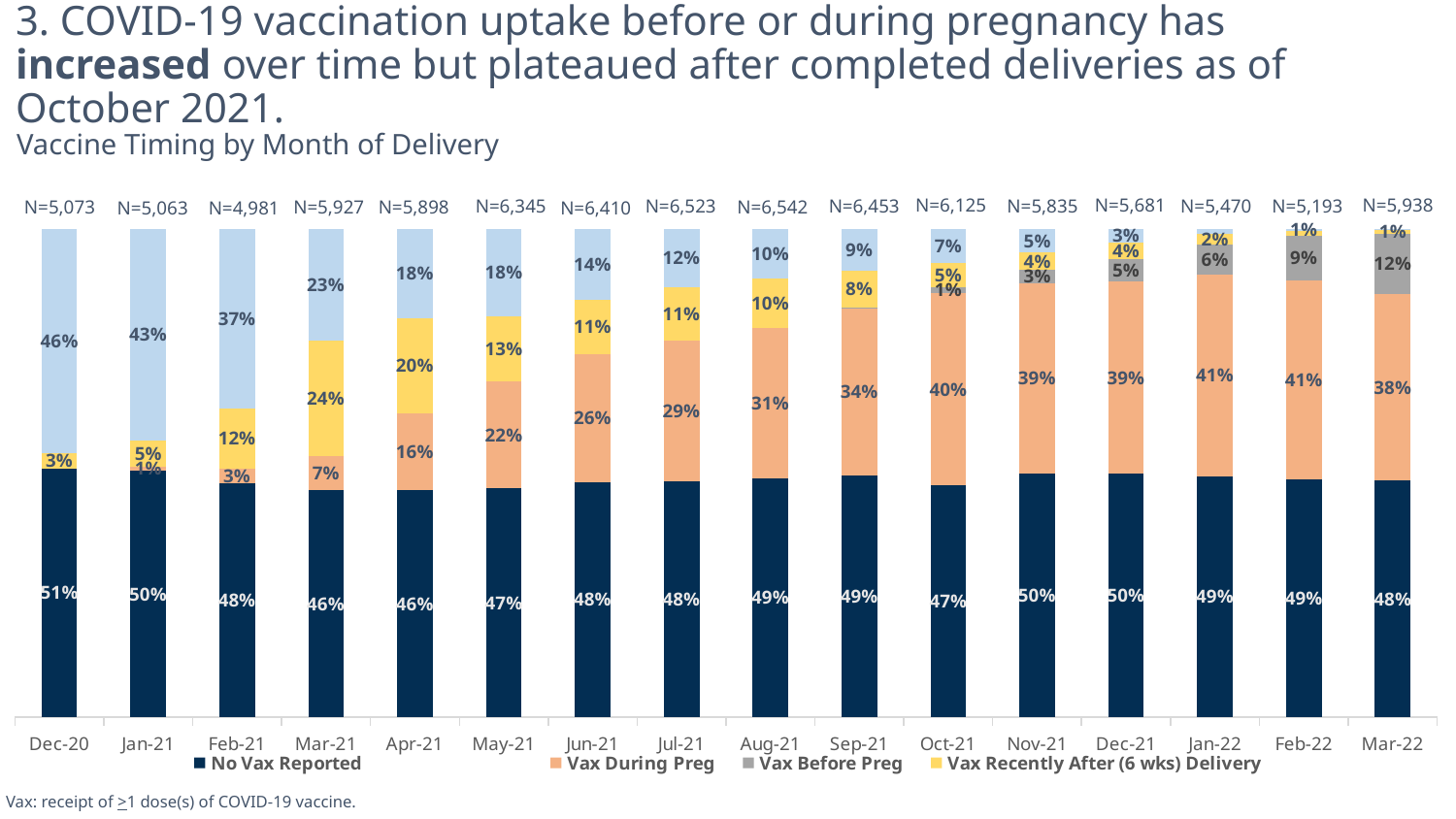
In which month is the Vax Before Preg share highest? Mar-22 What is the value for Vax During Preg in Oct-21? 40% In which month is the No Vax Reported share highest? Dec-20 What is the value for Vax Recently After (6 wks) Delivery in Mar-21? 24% What kind of chart is shown on the slide? Stacked bar chart What is the value for No Vax Reported in Dec-20? 51% Does the Vax During Preg share rise or fall from Mar-21 to Sep-21? Rise Which month has the larger Vax During Preg value, Jun-21 or Jul-21? Jul-21 What is the value for Vax Before Preg in Mar-22? 12% What is the difference between the Vax During Preg values for Sep-21 and Aug-21? 3 percentage points How many months of delivery are shown on the x axis? 16 How many series does the legend list? 4